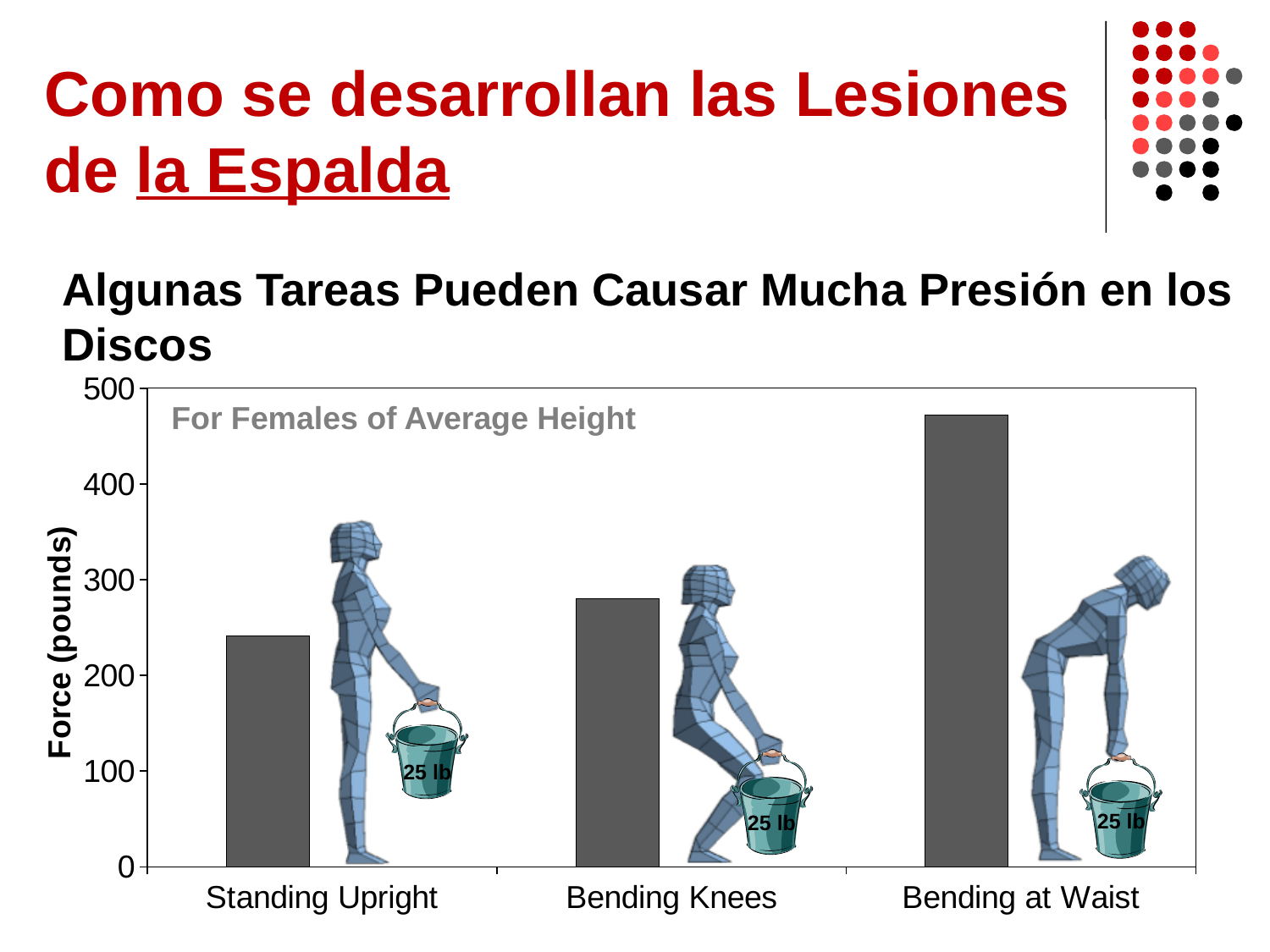
What weight is printed on the buckets in the chart illustrations? 25 lb Which category has the lowest force value? Standing Upright Do the bar values rise or fall from left to right across the x axis? rise Is the value for Bending at Waist greater or less than 400? greater What kind of chart is shown on the slide? bar chart Which has a larger force value, Standing Upright or Bending Knees? Bending Knees Is the value for Bending Knees greater or less than 200? greater Is the value for Standing Upright greater or less than 300? less What is the label of the vertical axis of the chart? Force (pounds) Which has a larger force value, Bending Knees or Bending at Waist? Bending at Waist How many categories are shown on the x axis of the chart? 3 Which category has the highest force value? Bending at Waist